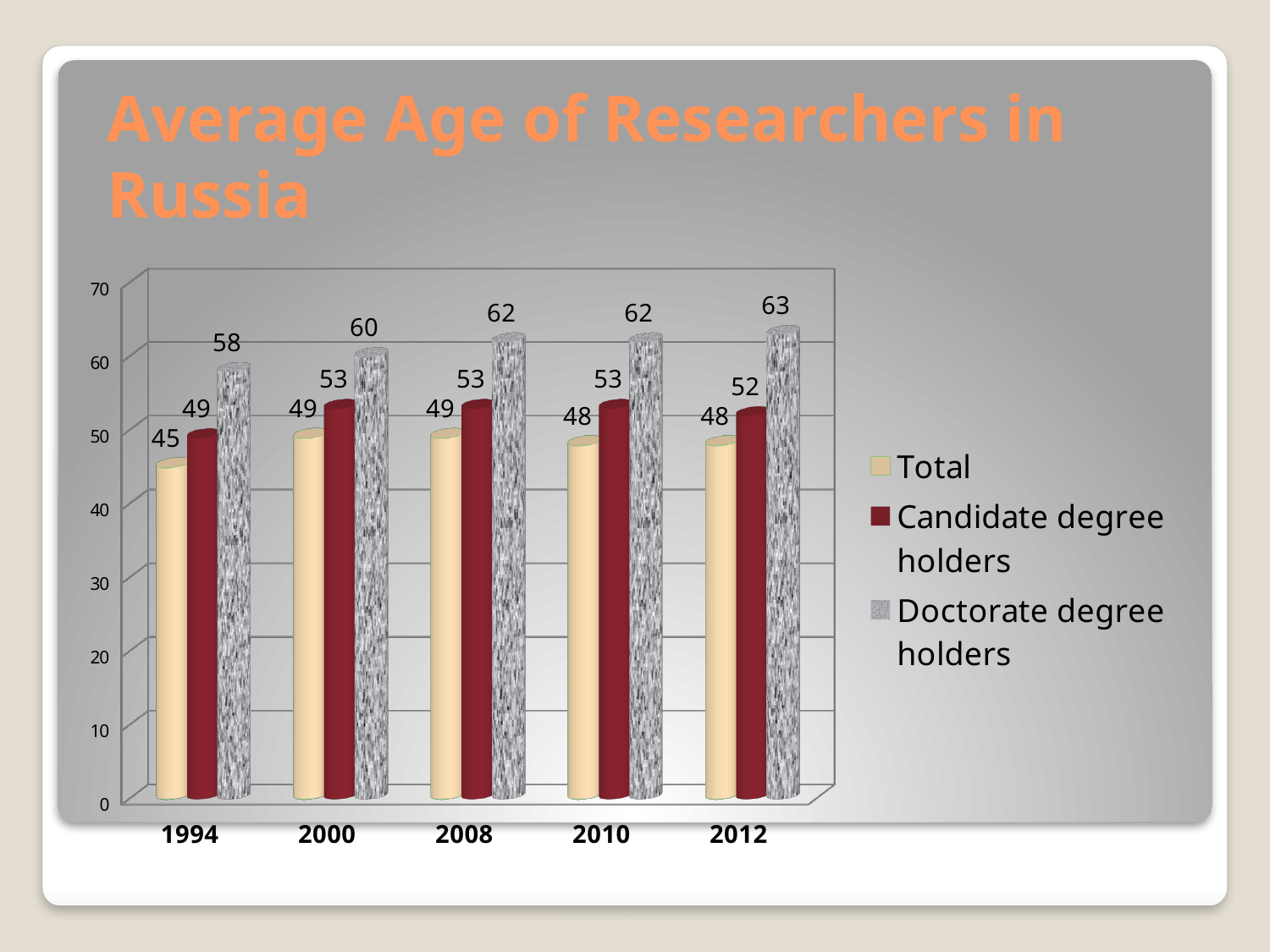
What is the value for Total in 1994? 45 What kind of chart is shown on the slide? bar chart Is the value for Doctorate degree holders in 2008 greater or less than 60? greater What is the value for Candidate degree holders in 2010? 53 What is the title of the chart? Average Age of Researchers in Russia In which year is the value for Doctorate degree holders lowest? 1994 In which year is the value for Doctorate degree holders highest? 2012 What is the average age of doctorate degree holders in 2012? 63 Which is larger in 2012: the value for Candidate degree holders or the value for Total? Candidate degree holders What is the difference between the Doctorate degree holders value and the Total value in 2000? 11 How many years are shown on the x axis? 5 How many series does the legend list? 3